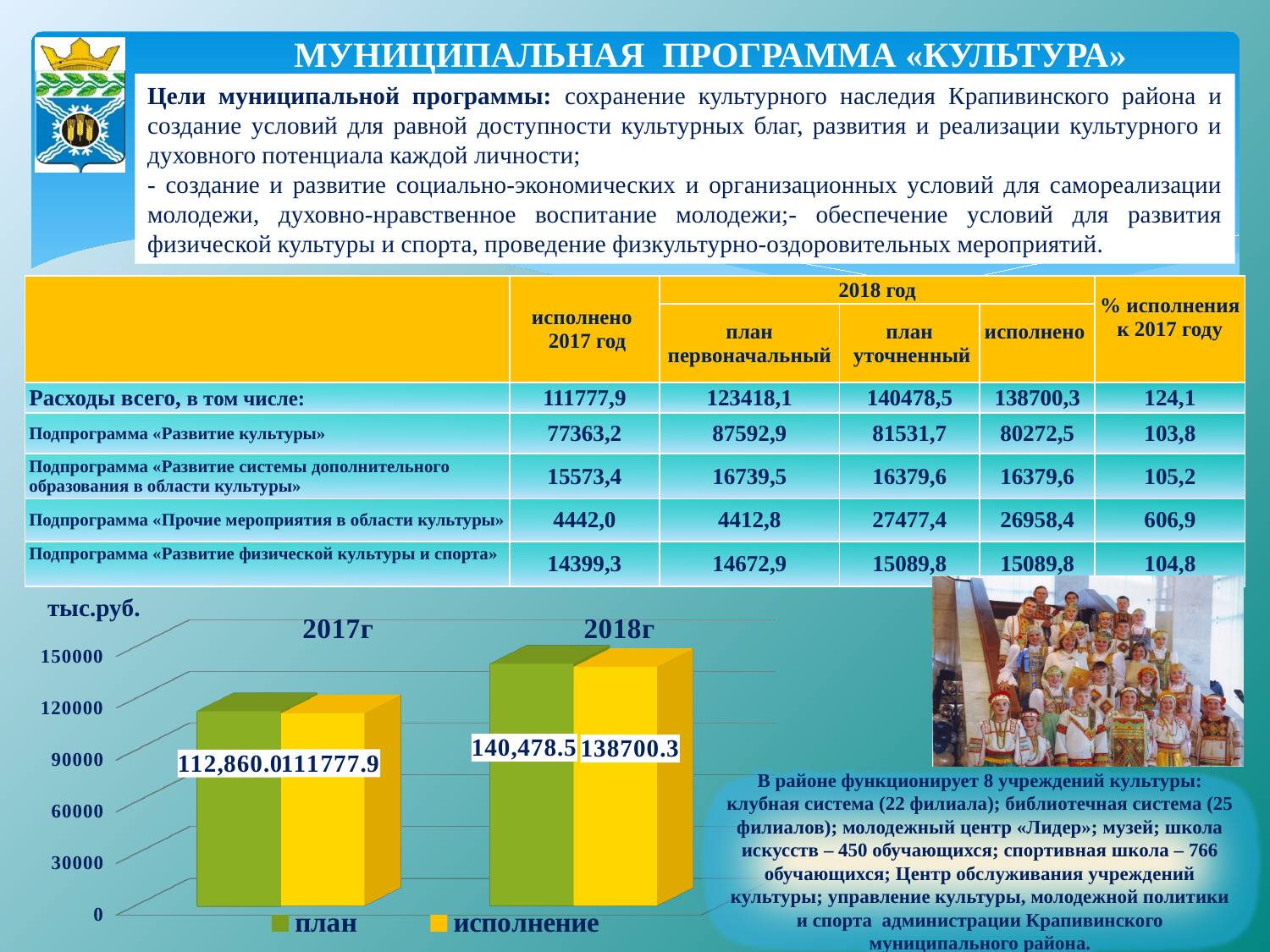
What kind of chart is shown at the bottom left of the slide? bar chart How many categories (years) are shown on the x axis of the bar chart? 2 Is the план value for 2017г in the bar chart greater or less than 90000? greater What is the value of исполнение for 2018г in the bar chart? 138700.3 What unit is indicated at the top of the vertical axis of the bar chart? тыс.руб. What is the value of план for 2018г in the bar chart? 140,478.5 Does the исполнение value rise or fall from 2017г to 2018г in the bar chart? rise How many series does the legend of the bar chart list? 2 What is the difference between the план and исполнение values for 2018г in the bar chart? 1778.2 What is the value of план for 2017г in the bar chart? 112,860.0 What is the value of исполнение for 2017г in the bar chart? 111777.9 Which year has the higher исполнение value in the bar chart, 2017г or 2018г? 2018г